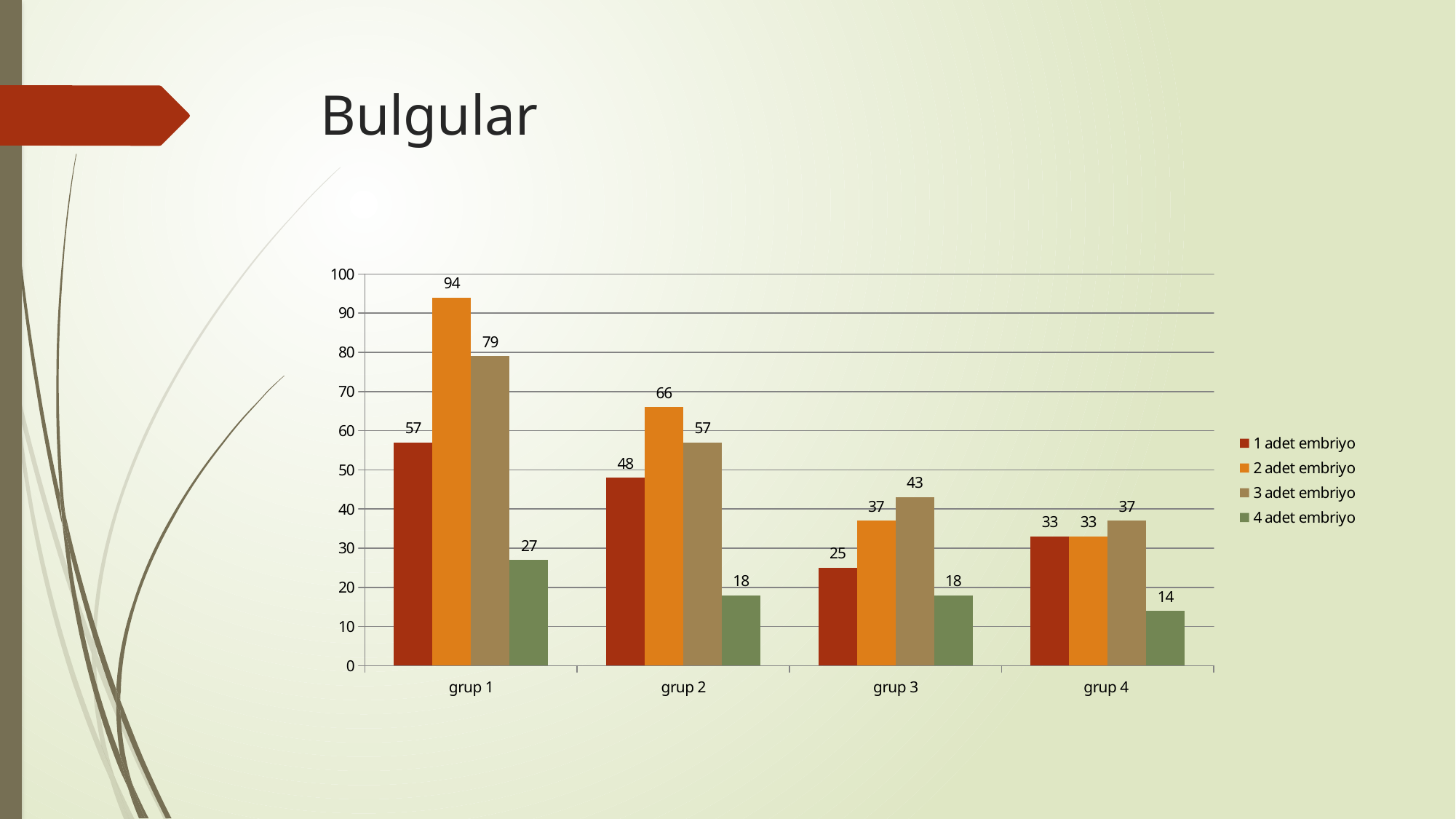
What kind of chart is shown on the slide? bar chart How many series does the legend list? 4 Is the value for "2 adet embriyo" in grup 3 greater or less than 40? less What is the value for "1 adet embriyo" in grup 3? 25 Do the values for "4 adet embriyo" generally rise or fall from grup 1 to grup 4? fall How many groups are shown on the x axis? 4 Which group has the lowest value for "1 adet embriyo"? grup 3 What is the value for "2 adet embriyo" in grup 1? 94 Which group has the highest value for "3 adet embriyo"? grup 1 What is the value for "4 adet embriyo" in grup 4? 14 Which is larger: the "3 adet embriyo" value in grup 3 or the "3 adet embriyo" value in grup 4? grup 3 What is the difference between the "2 adet embriyo" value and the "1 adet embriyo" value in grup 2? 18